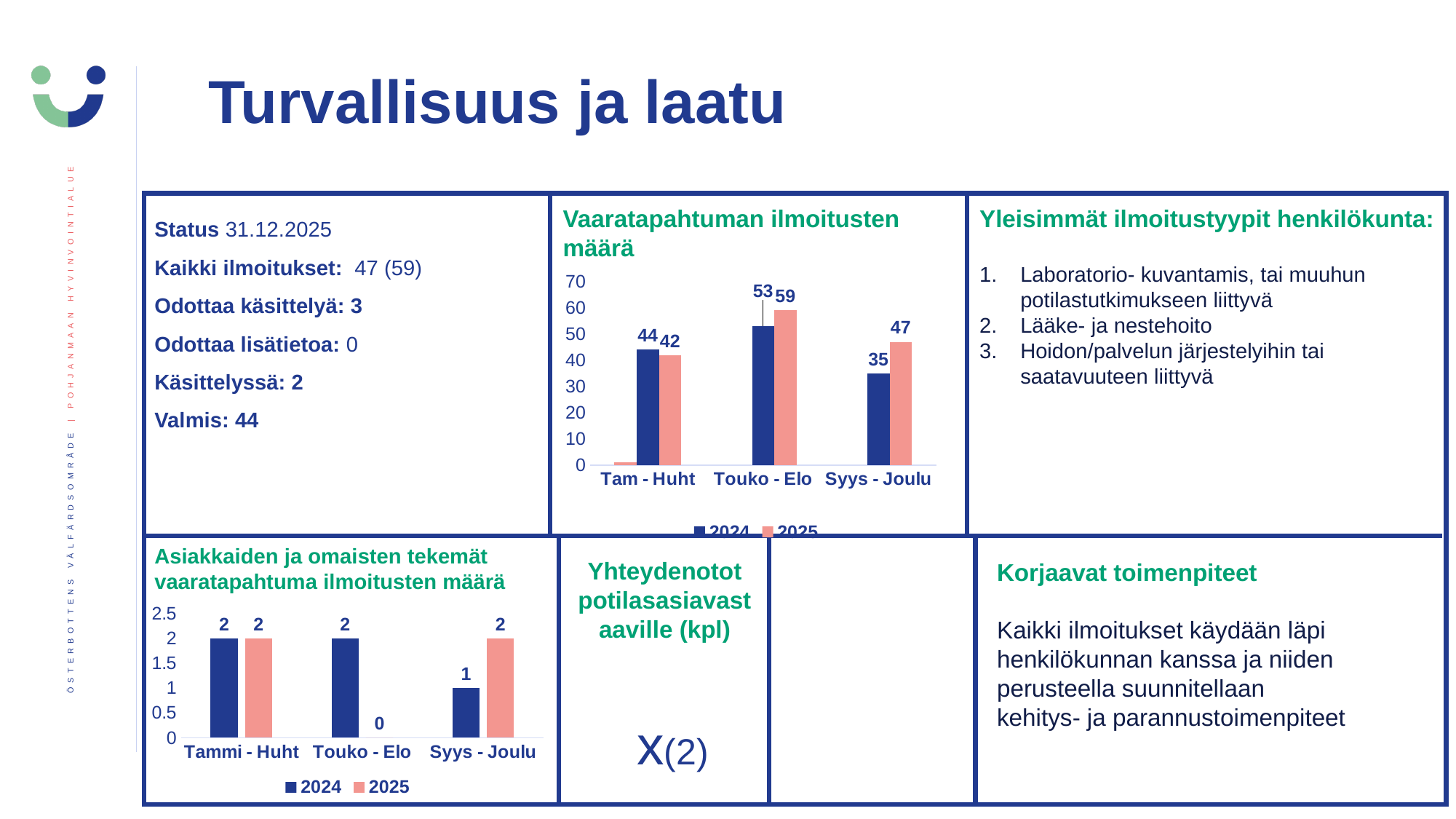
What kind of chart is 'Asiakkaiden ja omaisten tekemät vaaratapahtuma ilmoitusten määrä'? bar chart In the 'Vaaratapahtuman ilmoitusten määrä' chart, which period has the lowest 2025 value? Tam - Huht In the 'Asiakkaiden ja omaisten tekemät vaaratapahtuma ilmoitusten määrä' chart, which colour represents 2025? pink In the 'Vaaratapahtuman ilmoitusten määrä' chart, what is the difference between the 2025 and 2024 values for Syys - Joulu? 12 In the 'Vaaratapahtuman ilmoitusten määrä' chart, which period has the highest 2024 value? Touko - Elo In the 'Vaaratapahtuman ilmoitusten määrä' chart, what is the 2024 value for Syys - Joulu? 35 In the 'Vaaratapahtuman ilmoitusten määrä' chart, is the 2024 value for Tam - Huht larger or smaller than the 2025 value? larger In the 'Asiakkaiden ja omaisten tekemät vaaratapahtuma ilmoitusten määrä' chart, what is the 2024 value for Syys - Joulu? 1 In the 'Vaaratapahtuman ilmoitusten määrä' chart, how many series does the legend list? 2 In the 'Vaaratapahtuman ilmoitusten määrä' chart, what is the 2025 value for Touko - Elo? 59 How many periods are shown on the x axis of the 'Asiakkaiden ja omaisten tekemät vaaratapahtuma ilmoitusten määrä' chart? 3 In the 'Asiakkaiden ja omaisten tekemät vaaratapahtuma ilmoitusten määrä' chart, what is the 2025 value for Touko - Elo? 0